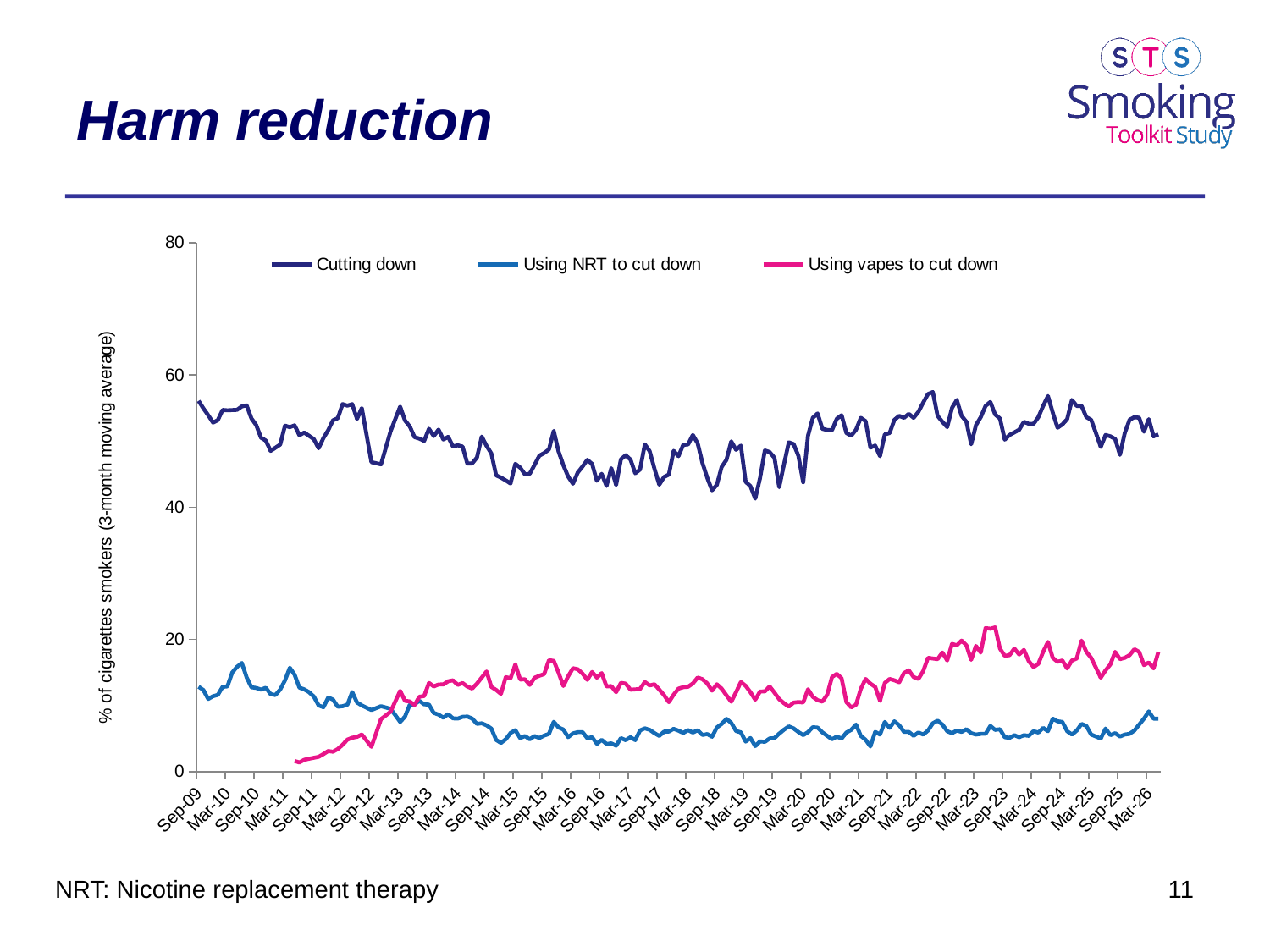
Does the Using NRT to cut down series rise or fall overall from Sep-09 to Mar-26? fall Is the value for Cutting down at Sep-09 greater or less than 40? greater Which series has the highest values across the whole period? Cutting down Which series is plotted in pink? Using vapes to cut down What is the label on the vertical axis? % of cigarettes smokers (3-month moving average) Is the value for Using NRT to cut down at Mar-26 greater or less than 20? less Is the value for Cutting down at Mar-19 greater or less than 60? less Does the Using vapes to cut down series rise or fall overall from Sep-11 to Mar-26? rise At Mar-26, which is larger: Using vapes to cut down or Using NRT to cut down? Using vapes to cut down What kind of chart is shown on the slide? Line chart How many series does the legend list? 3